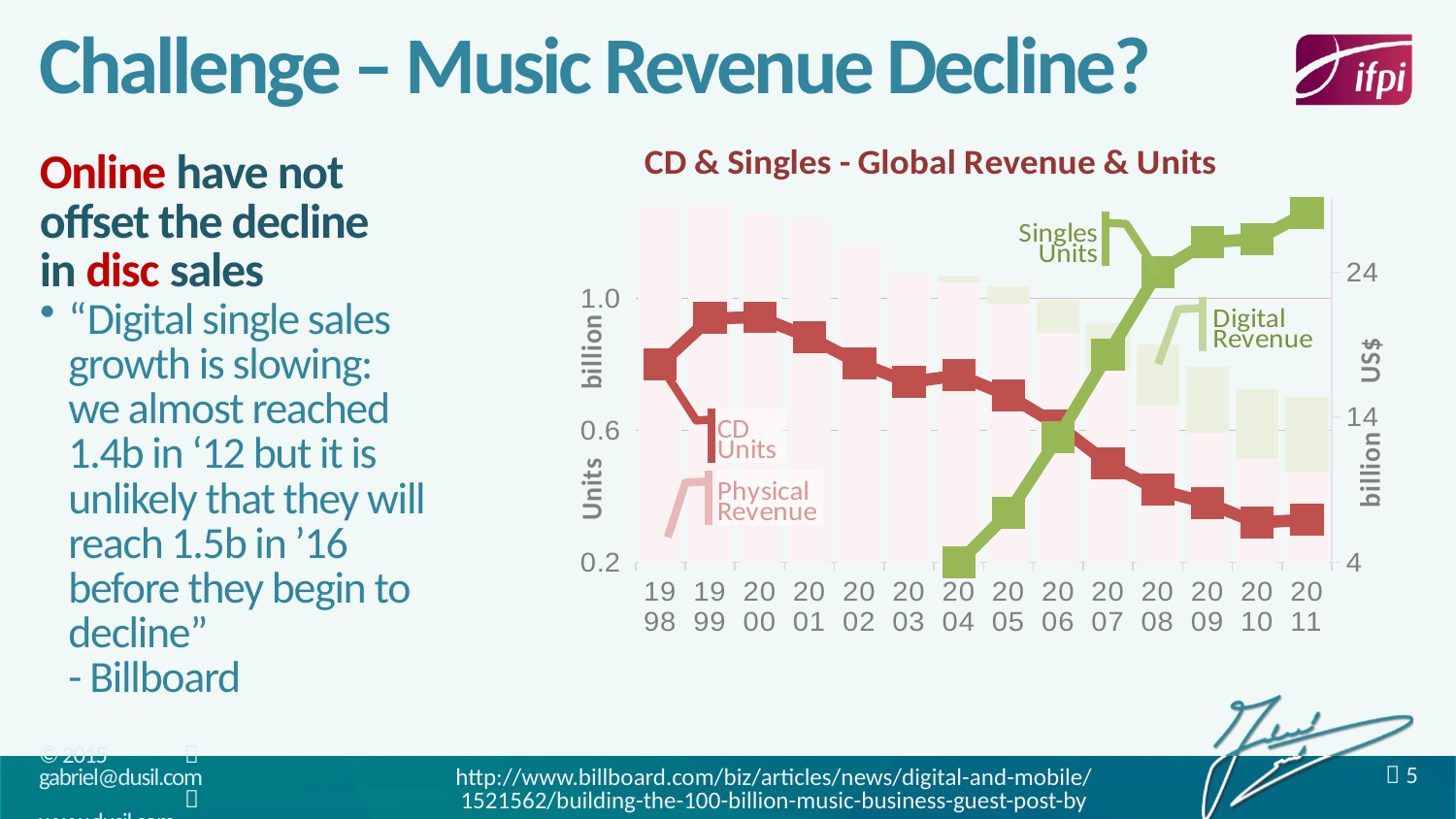
In which year is the Singles Units value highest? 2011 In which year is the Singles Units value lowest? 2004 What is the title of the chart? CD & Singles - Global Revenue & Units Is the Singles Units value for 2011 greater or less than 1.0 billion? greater Is the CD Units value for 1999 greater or less than 0.6 billion? greater How many years are shown along the x axis of the chart? 14 In 2008, which is larger: CD Units or Singles Units? Singles Units What kind of chart is shown on the slide? A combined line and bar chart Does the Singles Units line rise or fall from 2004 to 2011? Rise Does the CD Units line rise or fall from 1999 to 2011? Fall In 2005, which is larger: CD Units or Singles Units? CD Units How many data series are labelled on the chart? 4